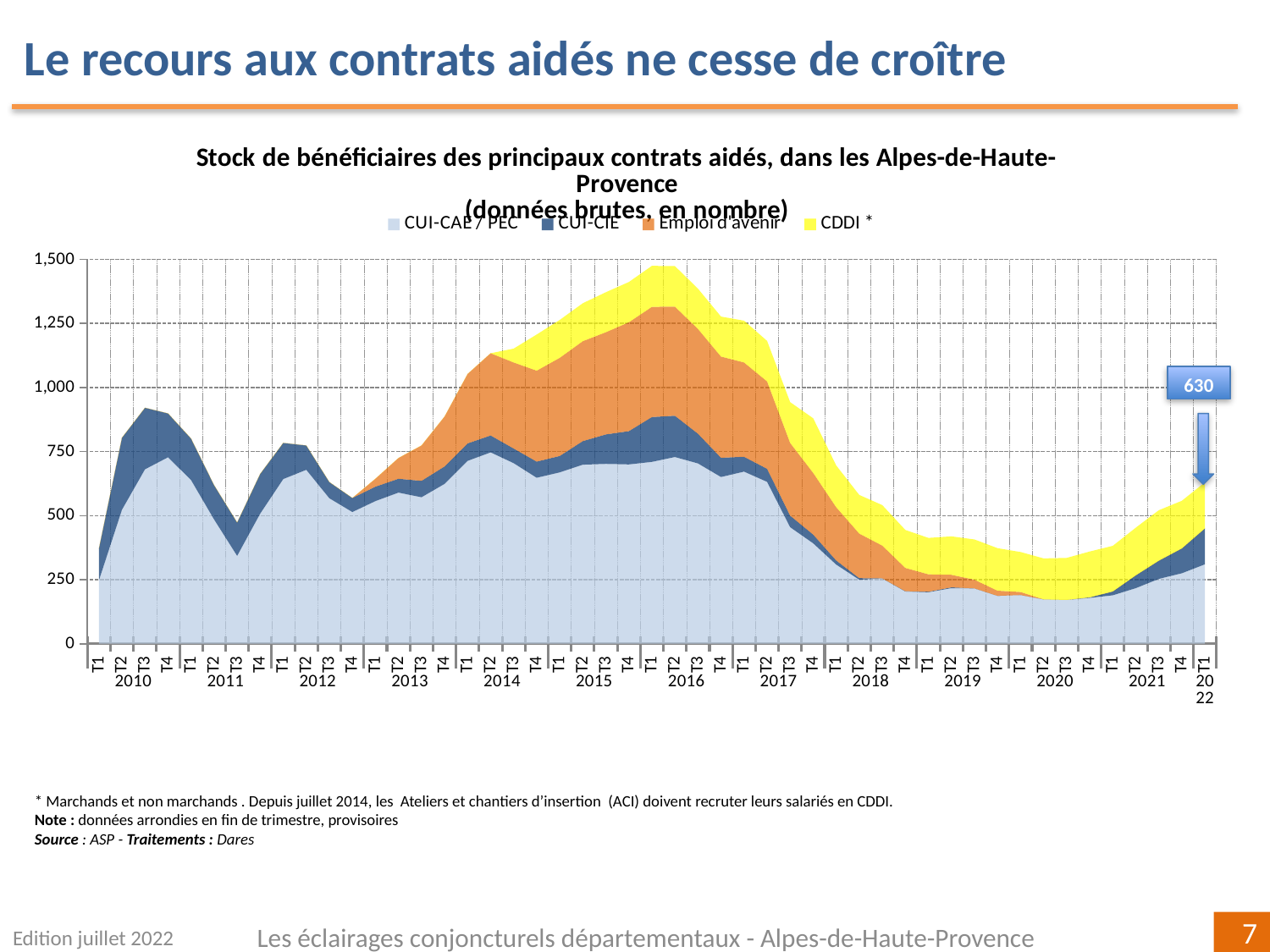
What value is shown in the callout for T1 2022? 630 Is the total stock at T1 2010 greater or less than 500? less What kind of chart is shown on the slide? Stacked area chart Is the total stock at T1 2016 greater or less than 1,250? greater How many series does the legend list? 4 Is the total stock at T1 2019 greater or less than 500? less Does the total stock rise or fall between T3 2020 and T1 2022? rise Which series is shown in yellow? CDDI * In which year does the total stock of beneficiaries reach its peak? 2016 Which series is plotted at the bottom of the stack? CUI-CAE / PEC What is the highest value shown on the y axis? 1,500